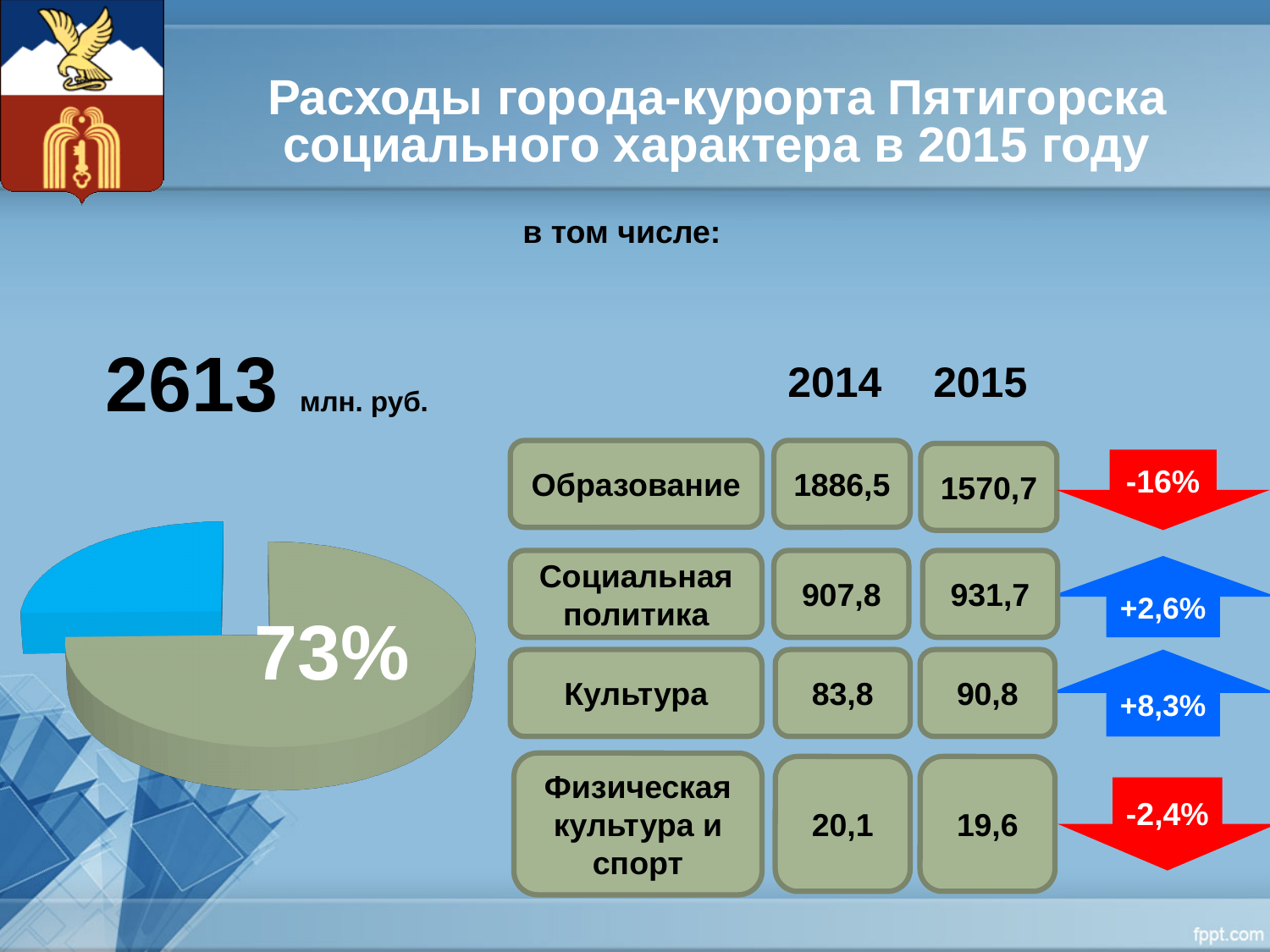
What percentage is printed on the large slice of the pie chart? 73% What colour is the smaller slice of the pie chart? blue How many slices does the pie chart have? 2 Which slice of the pie chart is larger, the grey one or the blue one? the grey one What total amount in млн. руб. is printed above the pie chart? 2613 What kind of chart is shown on the left of the slide? pie chart Is the share of the slice labelled 73% greater or less than 50%? greater